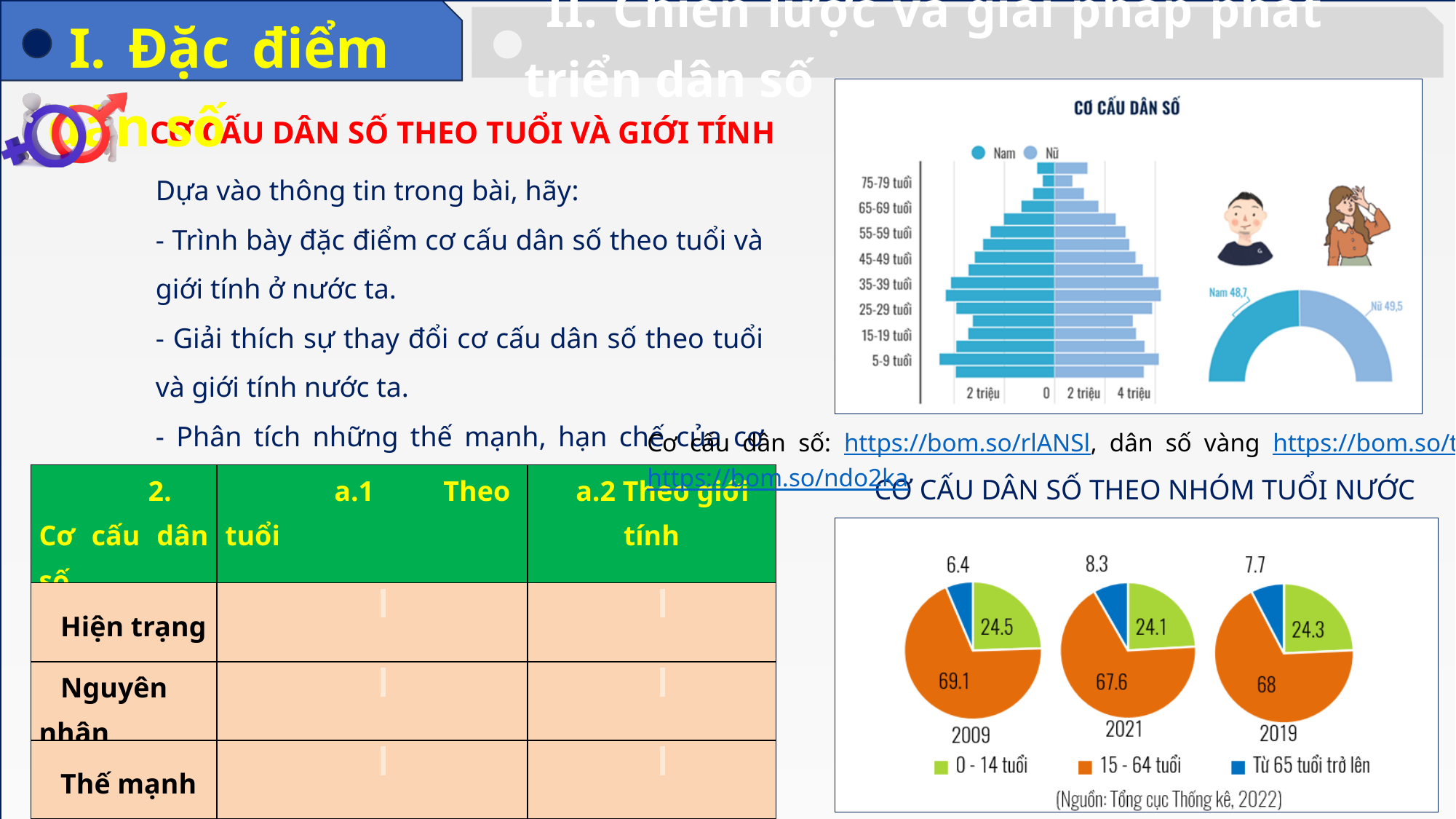
In the pie chart for 2021 in the bottom-right chart, what is the value for the Từ 65 tuổi trở lên group? 8.3 In the bottom-right pie charts, which year has the highest value for Từ 65 tuổi trở lên? 2021 In the top-right chart titled CƠ CẤU DÂN SỐ, what value is shown for Nam on the semicircle chart? 48,7 In the top-right chart titled CƠ CẤU DÂN SỐ, what are the two legend entries of the population pyramid? Nam, Nữ How many groups does the legend of the bottom-right pie charts list? 3 In the bottom-right pie charts, is the 0 - 14 tuổi value larger in 2009 or in 2019? 2009 In the pie chart for 2009 in the bottom-right chart, what is the value for the 15 - 64 tuổi group? 69.1 In the pie chart for 2019 in the bottom-right chart, what is the value for the 0 - 14 tuổi group? 24.3 In the bottom-right pie charts, what is the difference between the 15 - 64 tuổi value in 2009 and in 2021? 1.5 How many pie charts are shown in the bottom-right chart? 3 In the bottom-right pie charts, which year has the lowest value for Từ 65 tuổi trở lên? 2009 What kind of chart is the bottom-right chart titled CƠ CẤU DÂN SỐ THEO NHÓM TUỔI? Pie chart